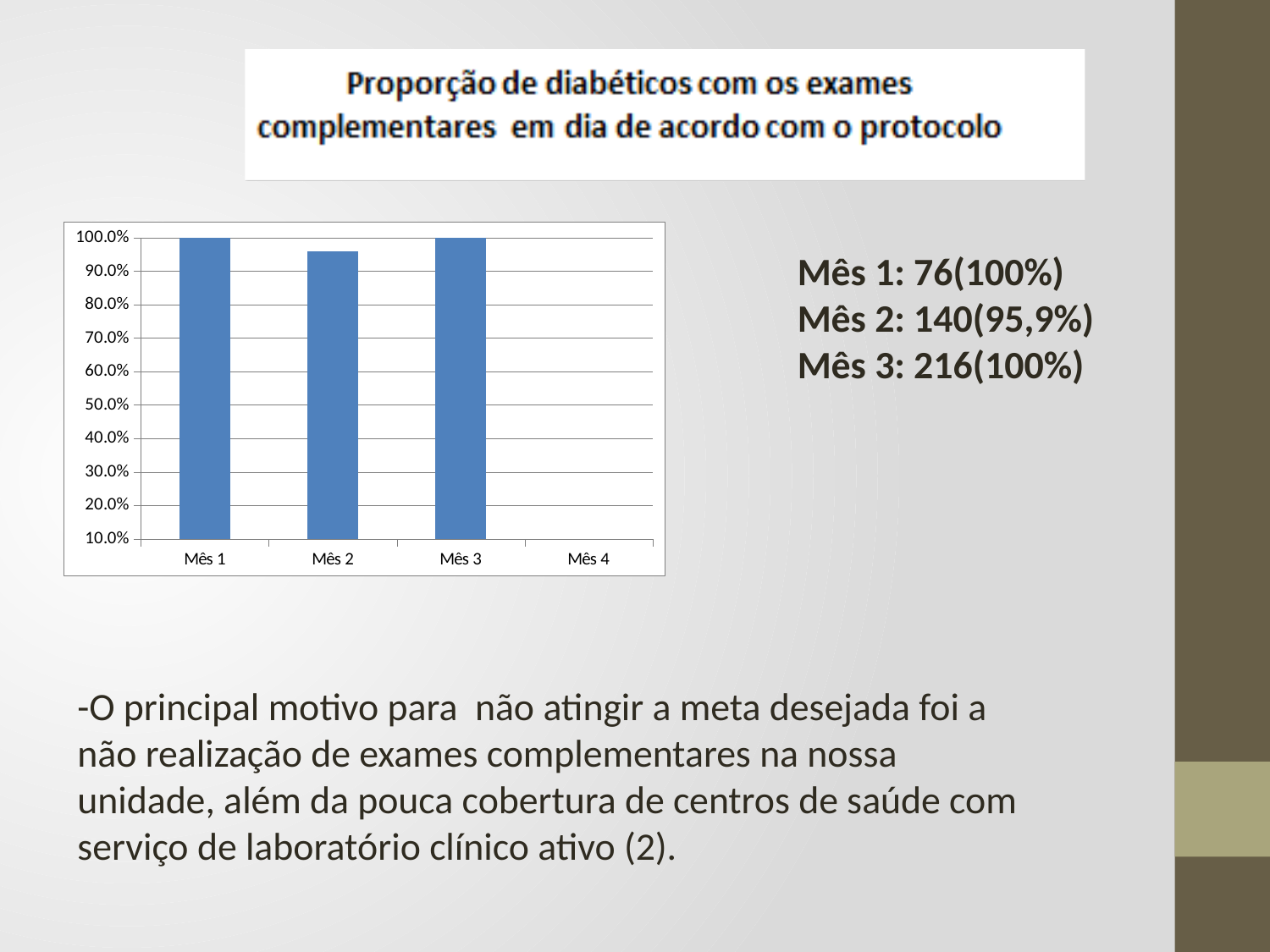
What is the value for Mês 2? 95,9% What kind of chart is shown on the slide? Bar chart Is the value for Mês 2 greater or less than 100%? less What is the value for Mês 3? 100% Is the value for Mês 2 greater or less than 90%? greater Among the months that have a bar, which has the lowest value? Mês 2 Which is larger, the value for Mês 1 or the value for Mês 2? Mês 1 What is the difference between the value for Mês 1 and the value for Mês 2? 4,1% Which month on the x axis has no bar plotted? Mês 4 What is the value for Mês 1? 100% How many categories are labelled on the x axis of the chart? 4 What is the title of the chart? Proporção de diabéticos com os exames complementares em dia de acordo com o protocolo